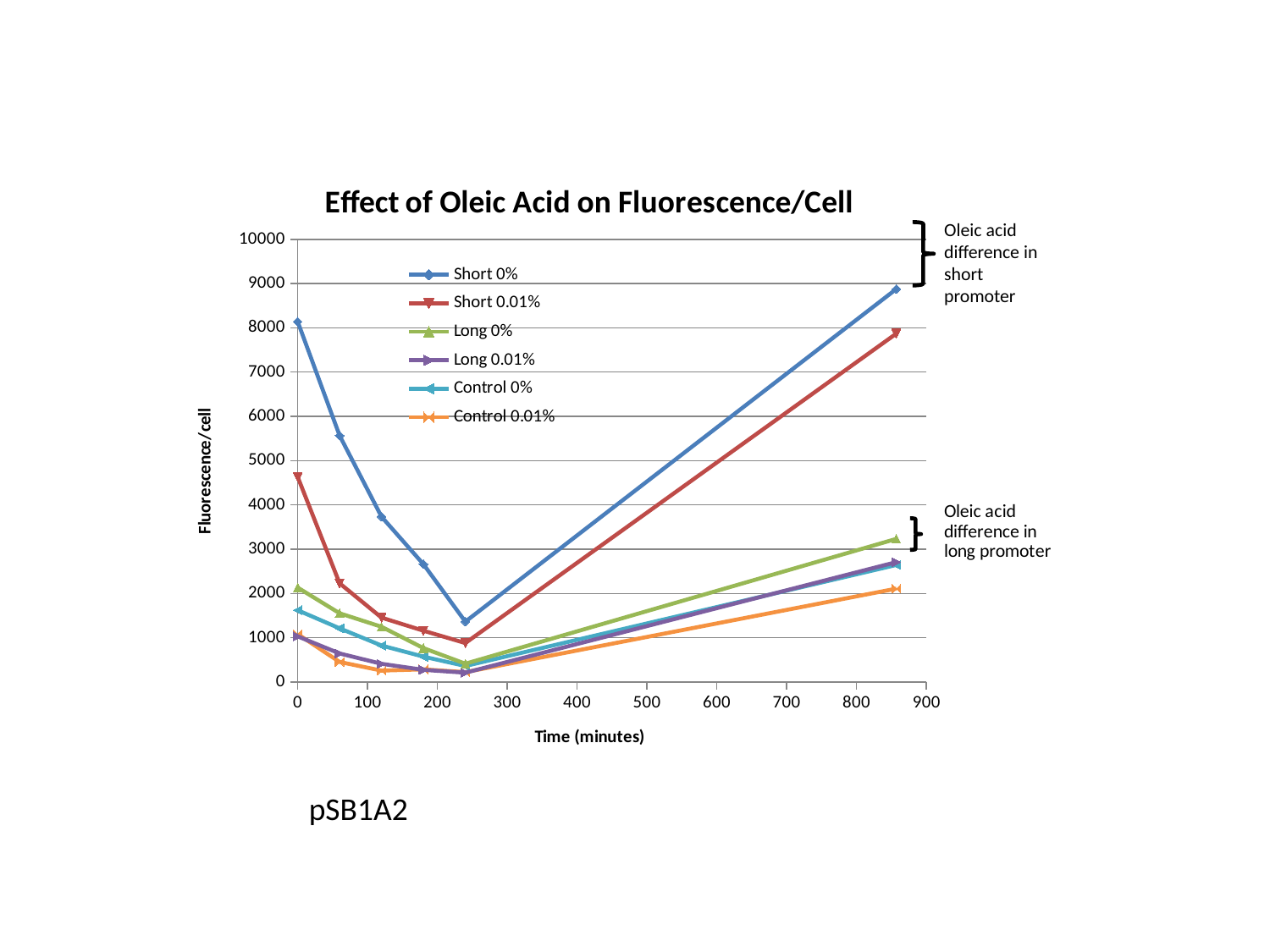
What is the label of the x axis? Time (minutes) How many series does the legend list? 6 Does the Short 0% series rise or fall between 0 and 240 minutes? fall Which series has the highest value at the last time point? Short 0% At the last time point, which is larger: Short 0% or Short 0.01%? Short 0% Is the value for Short 0.01% at time 0 greater or less than 5000? less How many data points does the Short 0% series have? 6 Which series has the lowest value at the last time point? Control 0.01% Is the value for Long 0% at the last time point greater or less than 3000? greater Is the value for Short 0% at time 0 greater or less than 7000? greater What kind of chart is shown on the slide? line chart What is the title of the chart? Effect of Oleic Acid on Fluorescence/Cell